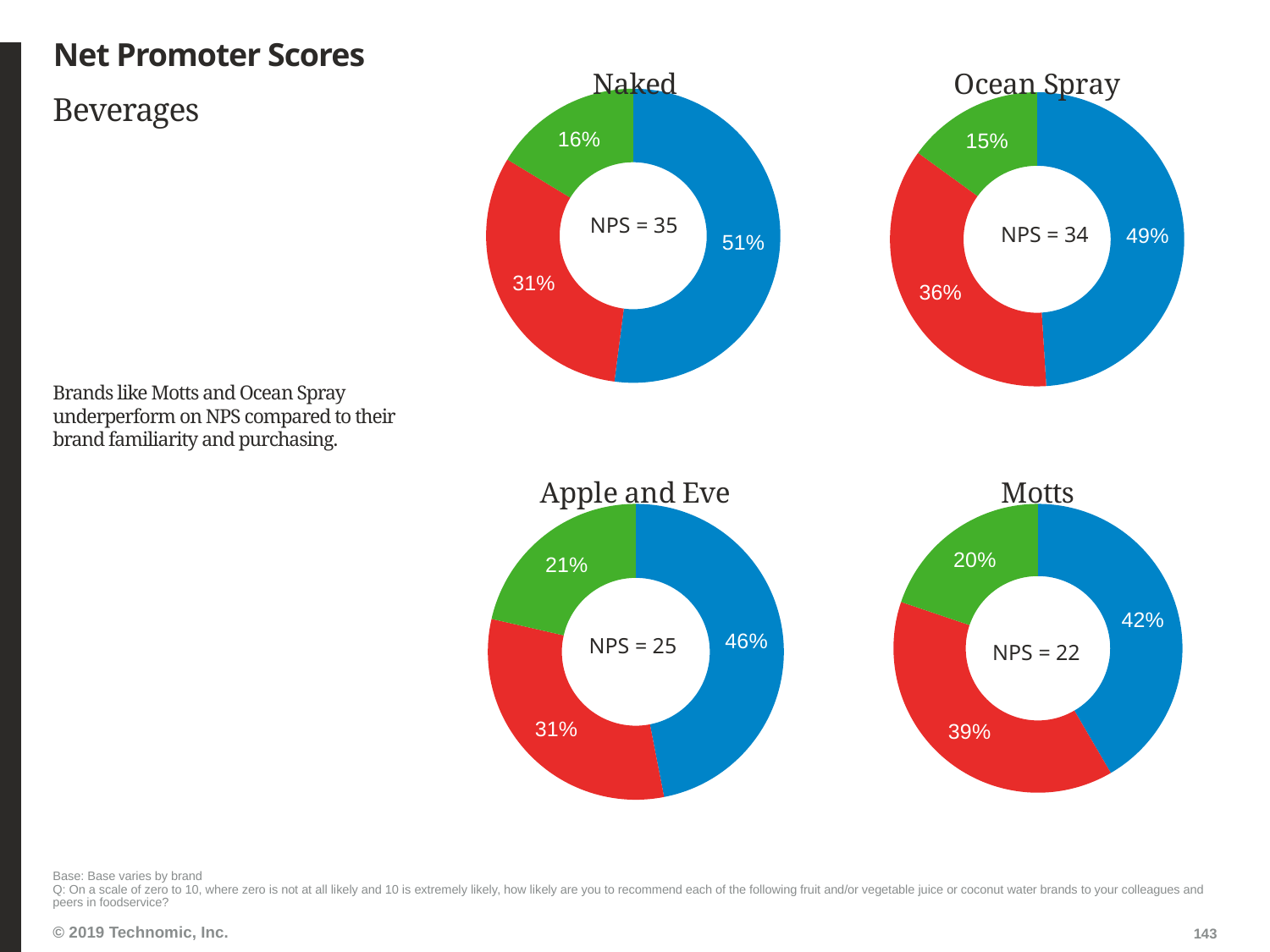
In the Motts chart, what percentage does the blue slice represent? 42% In the Motts chart, what is the difference between the red slice and the green slice? 19% How many slices does the Apple and Eve chart have? 3 In the Ocean Spray chart, which colour slice is the smallest? Green In the Naked chart, what percentage does the blue slice represent? 51% In the Ocean Spray chart, what percentage does the red slice represent? 36% How many charts are shown on the slide? 4 What kind of chart is used for Ocean Spray? Donut (pie) chart What NPS value is shown in the centre of the Motts chart? NPS = 22 In the Apple and Eve chart, what percentage does the green slice represent? 21% In the Naked chart, which colour slice is the largest? Blue Which chart shows a larger blue slice, Naked or Ocean Spray? Naked